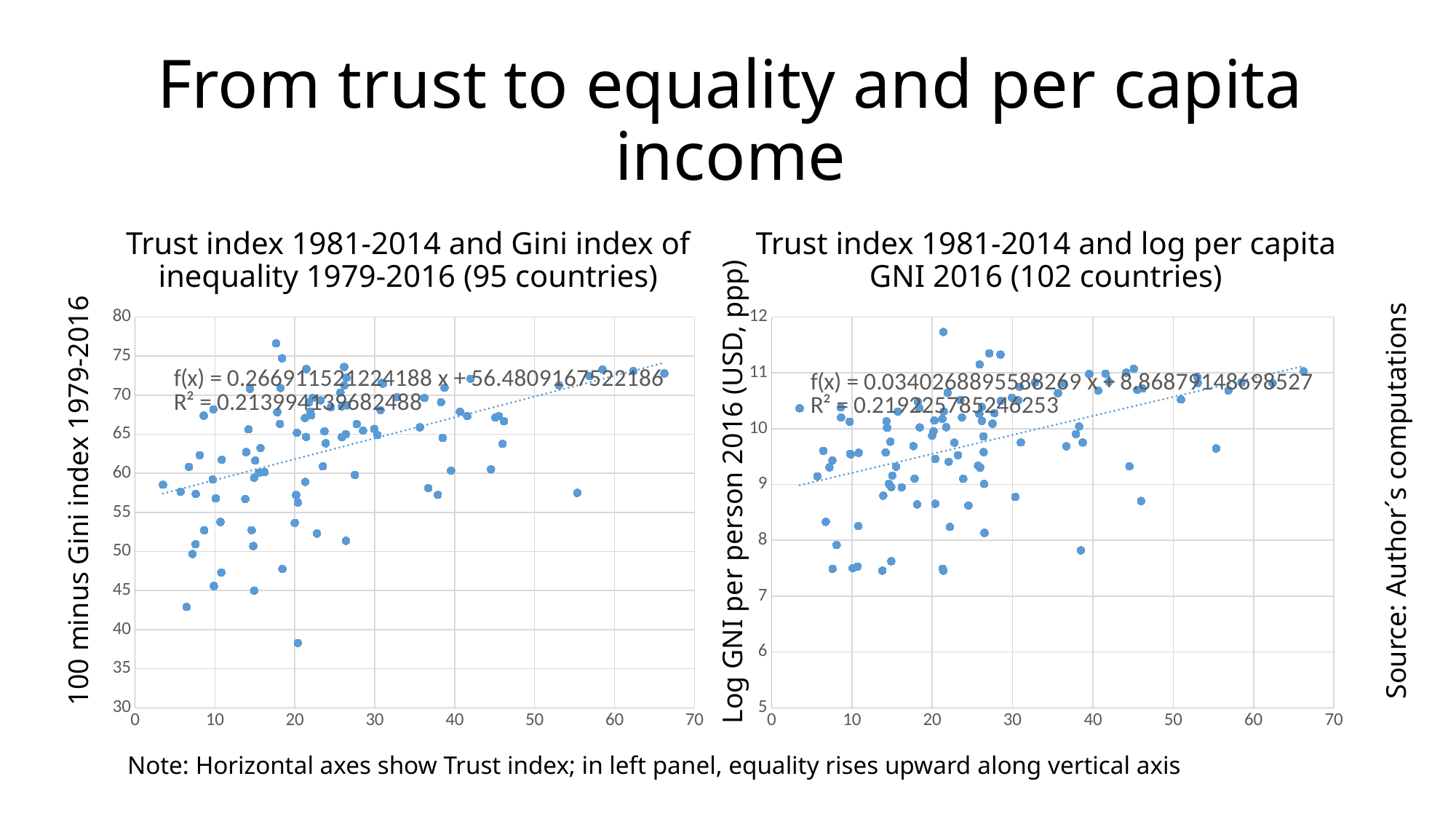
Which chart shows the higher R² value, the left chart (Gini index) or the right chart (log per capita GNI)? The right chart (log per capita GNI) In the left chart, 'Trust index 1981-2014 and Gini index of inequality 1979-2016', is the highest plotted point greater or less than 75 on the vertical axis? greater In the left chart, 'Trust index 1981-2014 and Gini index of inequality 1979-2016', does the fitted trend line rise or fall as the Trust index increases? Rises What is the fitted equation printed on the right chart, 'Trust index 1981-2014 and log per capita GNI 2016'? f(x) = 0.0340268895588269 x + 8.86879148698527 What is the R² value printed on the right chart, 'Trust index 1981-2014 and log per capita GNI 2016'? 0.219225785246253 What kind of chart is the left chart, 'Trust index 1981-2014 and Gini index of inequality 1979-2016 (95 countries)'? Scatter chart What is the R² value printed on the left chart, 'Trust index 1981-2014 and Gini index of inequality 1979-2016'? 0.213994139682488 According to its title, how many countries are plotted in the right chart, 'Trust index 1981-2014 and log per capita GNI 2016'? 102 In the right chart, 'Trust index 1981-2014 and log per capita GNI 2016 (102 countries)', does the fitted trend line rise or fall as the Trust index increases? Rises What is the vertical axis label of the right chart, 'Trust index 1981-2014 and log per capita GNI 2016'? Log GNI per person 2016 (USD, ppp) According to its title, how many countries are plotted in the left chart, 'Trust index 1981-2014 and Gini index of inequality 1979-2016'? 95 In the right chart, 'Trust index 1981-2014 and log per capita GNI 2016', is the highest plotted point greater or less than 11 on the vertical axis? greater